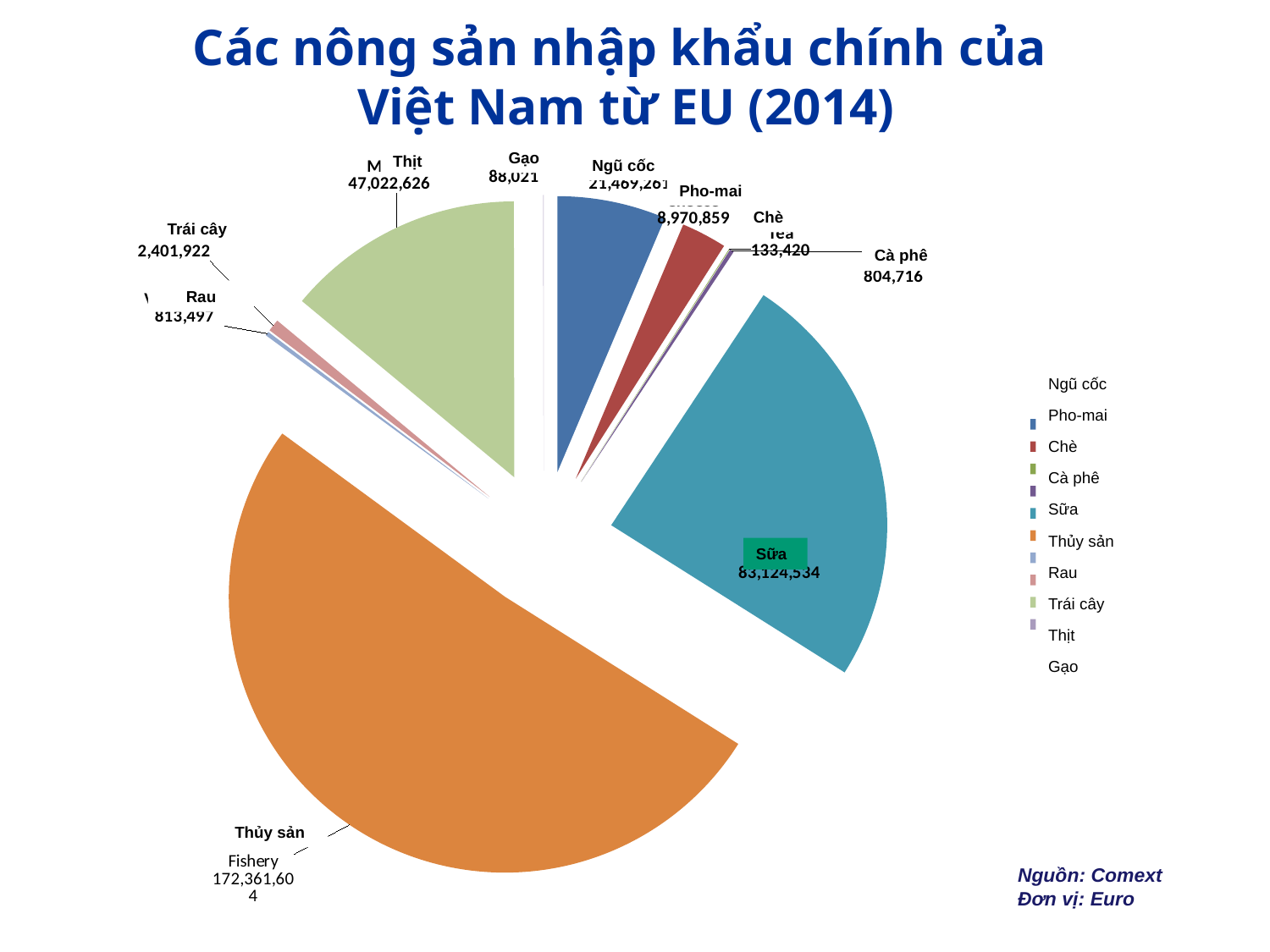
What is the value for Pho-mai? 8,970,859 What is the value for Thủy sản? 172,361,604 What is the value for Cà phê? 804,716 Which is larger, the value for Sữa or the value for Pho-mai? Sữa What is the value for Sữa? 83,124,534 What is the value for Gạo? 88,021 What type of chart is shown on the slide? Pie chart What unit are the values in, according to the note on the slide? Euro What is the value for Chè? 133,420 How many categories does the legend list? 10 What is the difference between the values for Thủy sản and Sữa? 89,237,070 Which category has the largest slice of the pie? Thủy sản